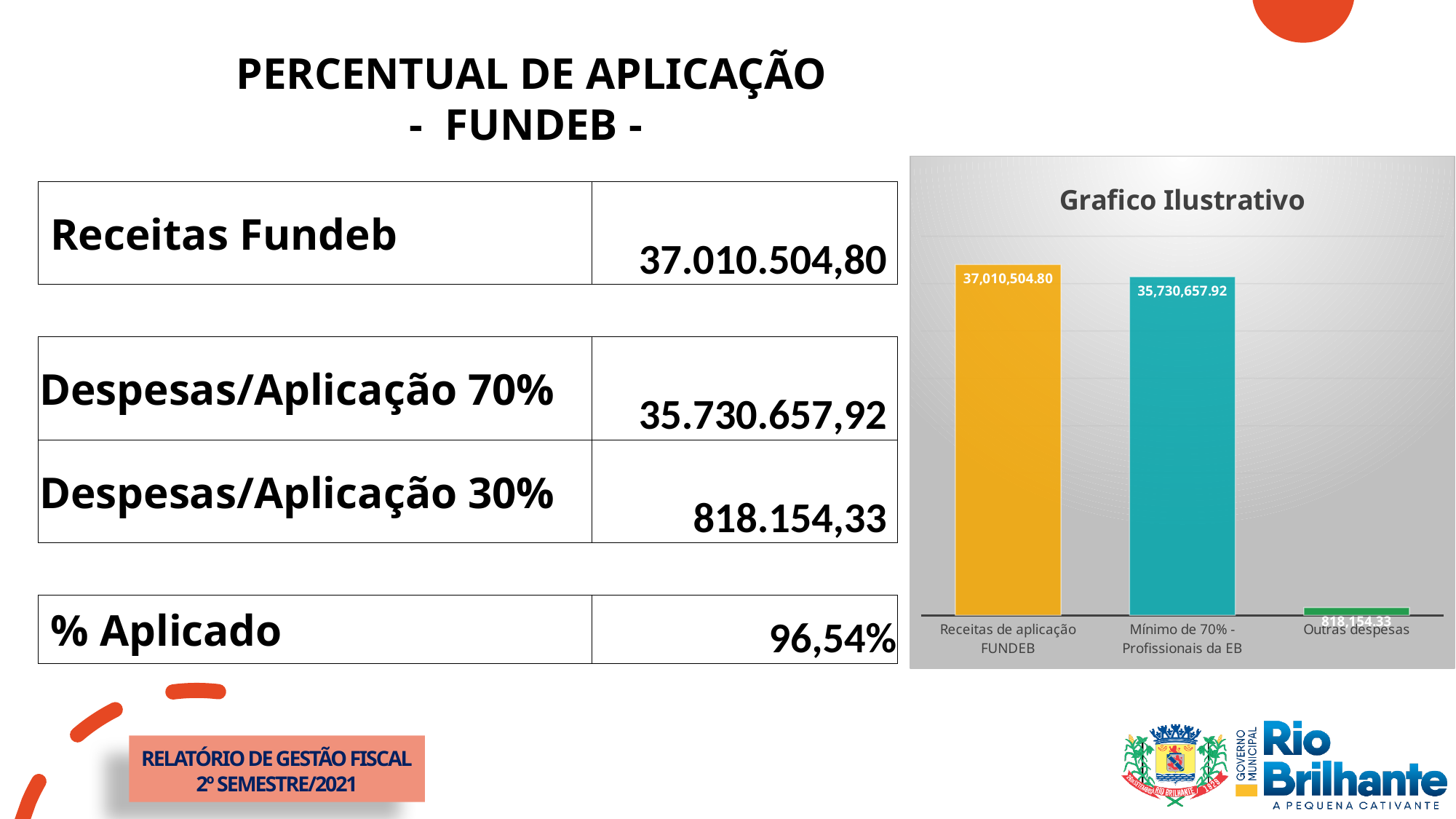
Which category has the highest value in the chart? Receitas de aplicação FUNDEB Which category has the lowest value in the chart? Outras despesas How many bars does the chart have? 3 What is the value of the bar for Mínimo de 70% - Profissionais da EB? 35,730,657.92 What is the value of the bar for Outras despesas? 818,154.33 What is the title of the chart? Grafico Ilustrativo What is the value of the bar for Receitas de aplicação FUNDEB? 37,010,504.80 What is the difference between the Receitas de aplicação FUNDEB bar and the Mínimo de 70% - Profissionais da EB bar? 1,279,846.88 What colour is the bar for Receitas de aplicação FUNDEB? orange/yellow What type of chart is shown on the slide? bar chart Which is larger, the bar for Mínimo de 70% - Profissionais da EB or the bar for Outras despesas? Mínimo de 70% - Profissionais da EB What is the difference between the Mínimo de 70% - Profissionais da EB bar and the Outras despesas bar? 34,912,503.59